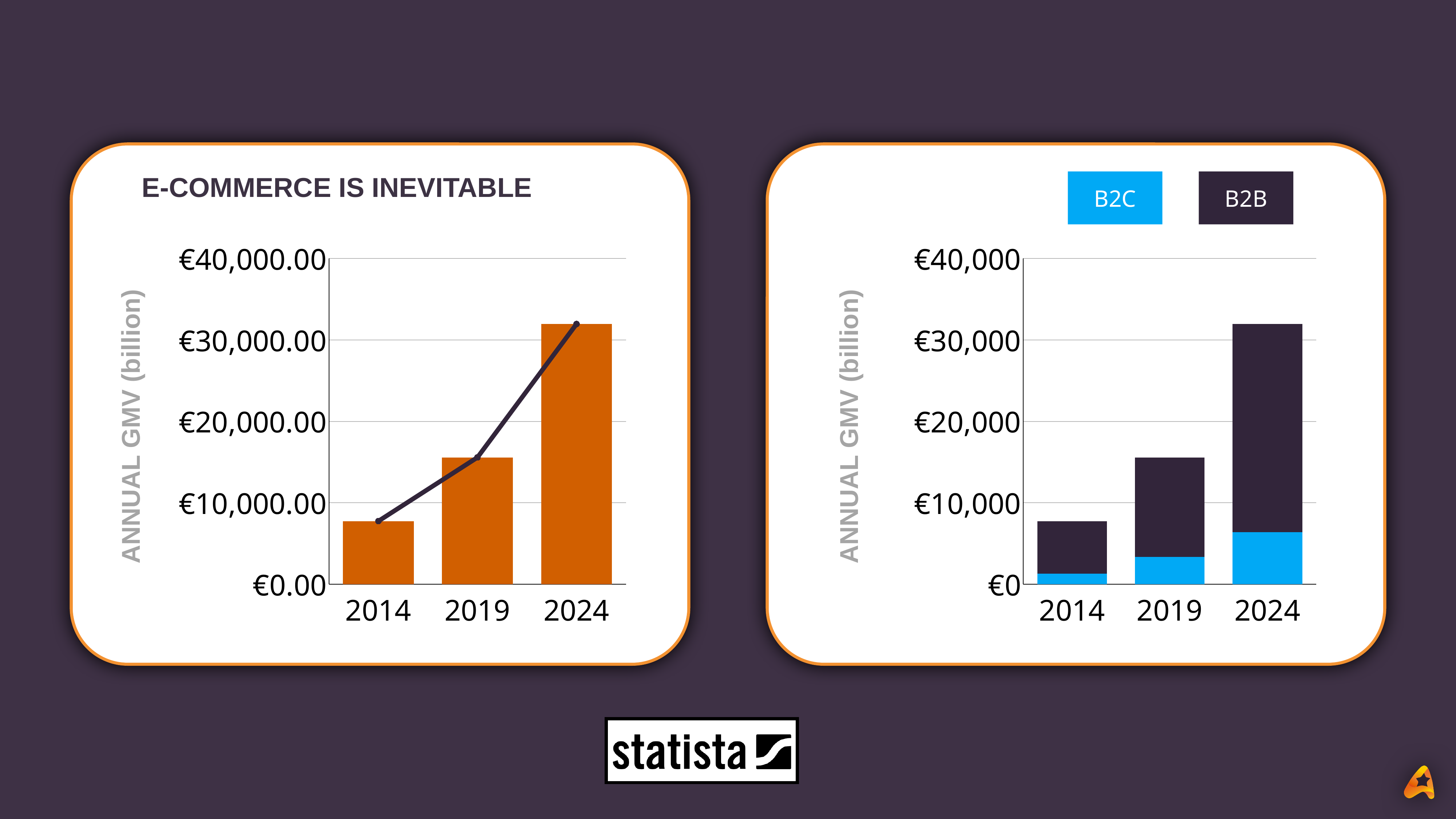
In the right chart, is the total stacked value for 2019 greater or less than €10,000? greater In the left chart titled "E-COMMERCE IS INEVITABLE", how many years are shown on the x axis? 3 In the left chart titled "E-COMMERCE IS INEVITABLE", do the values rise or fall from 2014 to 2024? Rise In the left chart titled "E-COMMERCE IS INEVITABLE", is the value for 2014 greater or less than €10,000.00? less In the right chart, how many series does the legend list? 2 In the right chart, which series is shown in light blue? B2C In the left chart titled "E-COMMERCE IS INEVITABLE", what is the y-axis label? ANNUAL GMV (billion) In the left chart titled "E-COMMERCE IS INEVITABLE", what kind of chart is shown? Bar chart with a line overlay In the left chart titled "E-COMMERCE IS INEVITABLE", which year has the lowest annual GMV? 2014 In the right chart, which is larger in 2024, the B2B segment or the B2C segment? B2B In the left chart titled "E-COMMERCE IS INEVITABLE", is the value for 2024 greater or less than €30,000.00? greater In the left chart titled "E-COMMERCE IS INEVITABLE", which year has the highest annual GMV? 2024